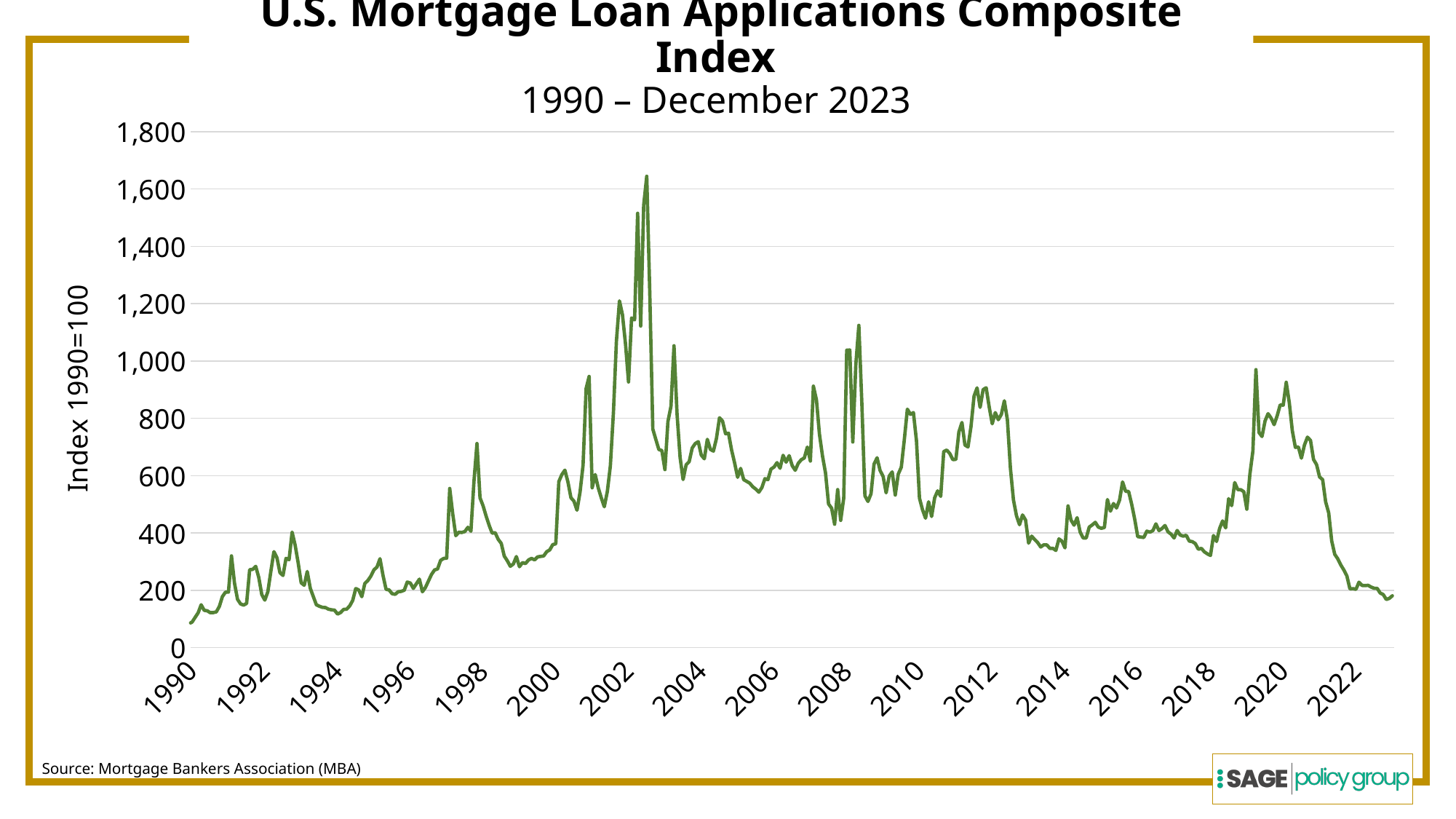
Does the index generally rise or fall from 1990 to its peak in the early 2000s? Rise What kind of chart is shown on the slide? Line chart Between which two labelled years on the x axis does the index reach its all-time peak? 2002 and 2004 Is the peak of the index around 2020 greater or less than 800? greater Is the highest value reached by the index greater or less than 1,400? greater What is the title of the chart? U.S. Mortgage Loan Applications Composite Index How many data series are plotted on the chart? 1 Is the value of the index at the start of 1990 greater or less than 200? less What is the label on the vertical axis of the chart? Index 1990=100 Does the index rise or fall from 2021 to the end of 2023? Fall